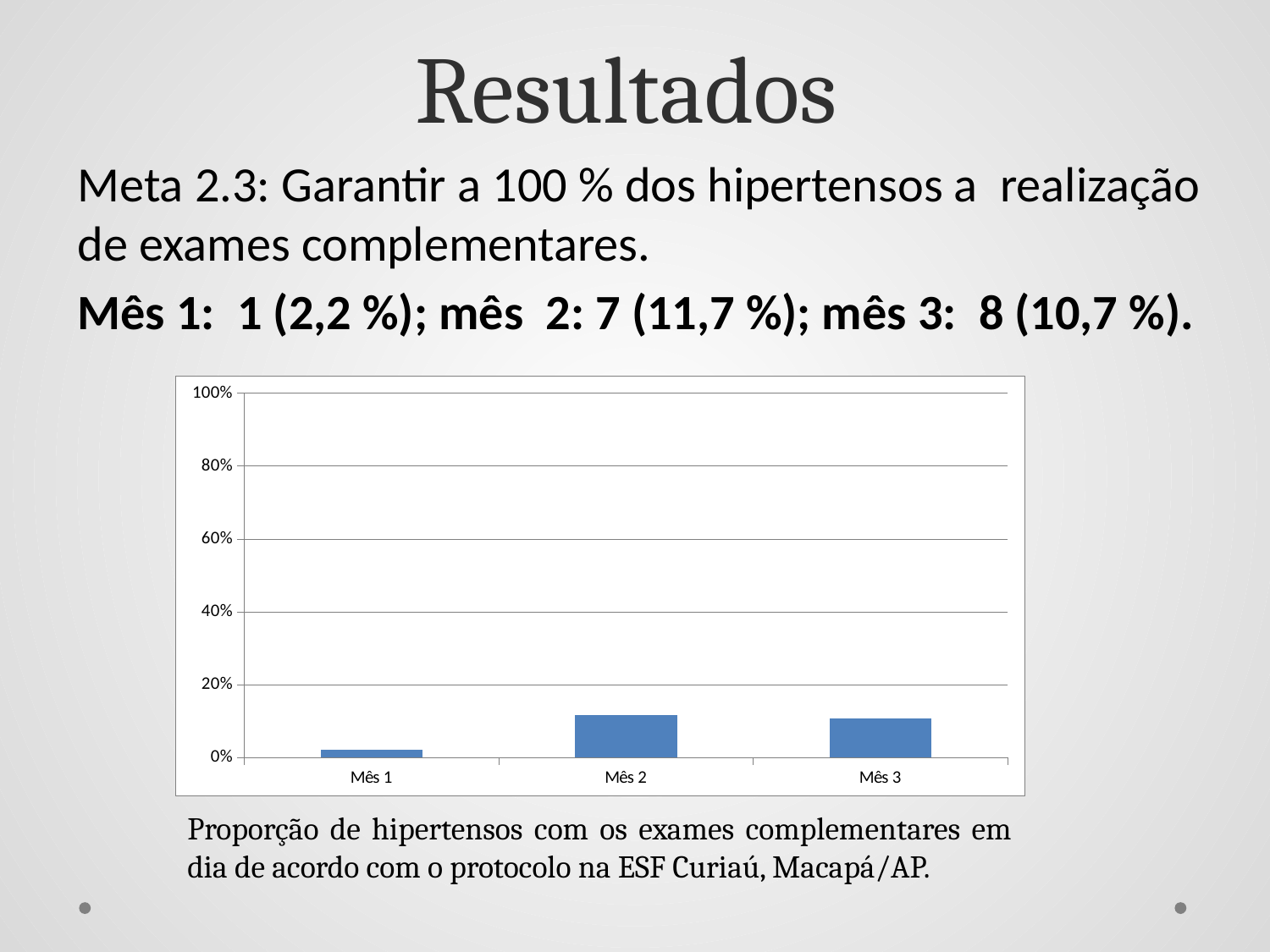
According to the slide, what is the proportion for Mês 1? 2,2 % Is the value for Mês 1 greater or less than 20%? less Is the value for Mês 2 greater or less than 20%? less How many categories (months) are plotted on the x axis of the chart? 3 According to the slide, what is the proportion for Mês 3? 10,7 % Which month has the lowest bar in the chart? Mês 1 Which month has the highest proportion in the chart? Mês 2 Which is larger, the value for Mês 1 or the value for Mês 3? Mês 3 What is the highest value shown on the chart's y axis? 100% What is the difference in percentage points between Mês 2 and Mês 1? 9,5 % What kind of chart is shown on the slide? bar chart According to the slide, what is the proportion for Mês 2? 11,7 %